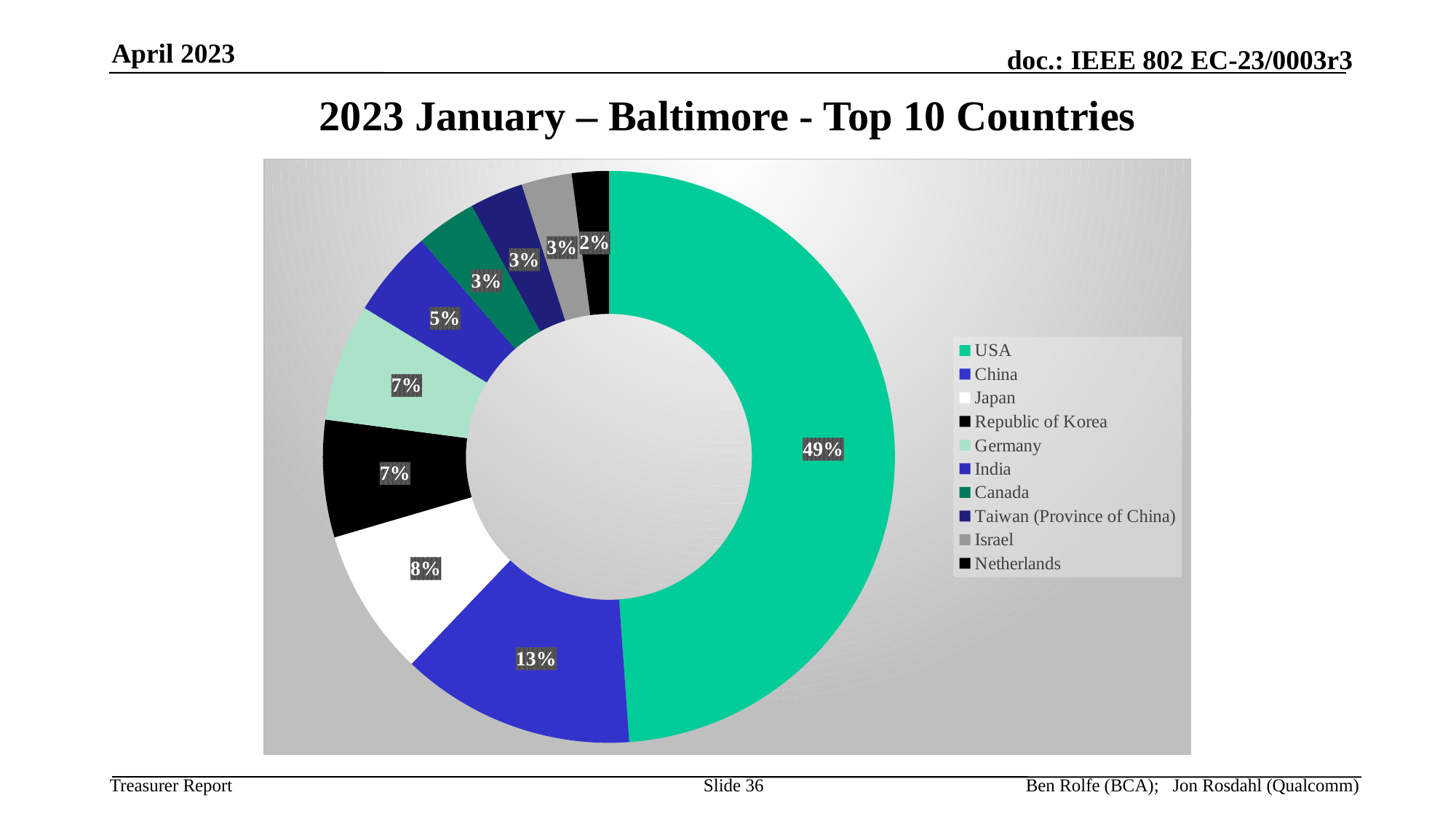
What is the value shown for Japan? 8% Which country has the smallest share of the chart? Netherlands What kind of chart is shown on the slide? Pie chart (doughnut) How many countries are shown in the chart? 10 What is the value shown for India? 5% Which country has the largest share of the chart? USA What is the value shown for Netherlands? 2% What share of the pie does USA have? 49% What is the title of the slide? 2023 January – Baltimore - Top 10 Countries What is the value shown for China? 13% What is the difference between the shares of USA and China? 36% Which has a larger share, Japan or India? Japan